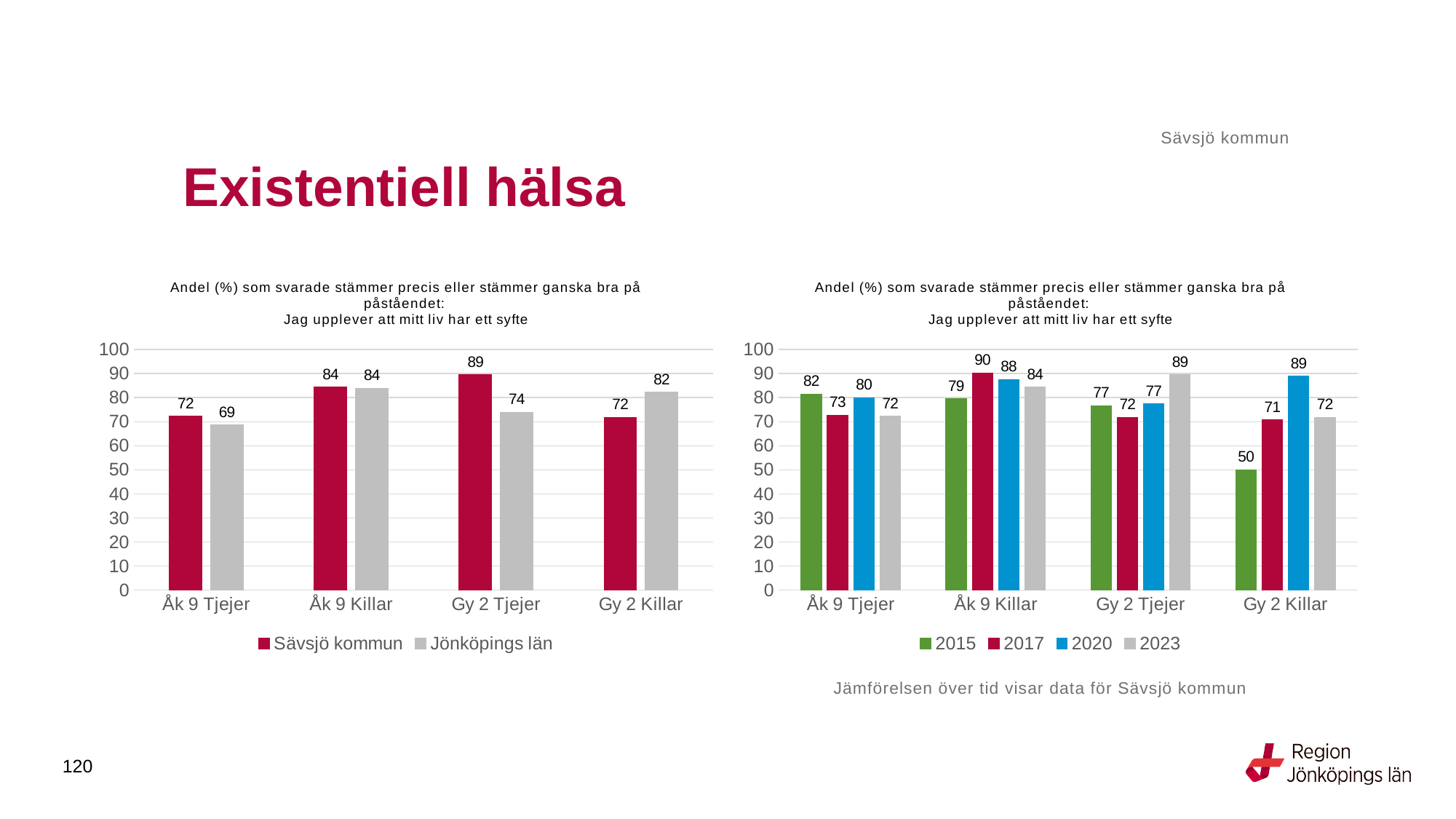
In the left chart, what is the value for Jönköpings län for Åk 9 Tjejer? 69 In the left chart, how many series does the legend list? 2 In the right chart, how many series does the legend list? 4 In the right chart, what is the difference between 2020 and 2017 for Gy 2 Killar? 18 What kind of chart is the left chart? Bar chart How many categories are shown on the x axis of the right chart? 4 In the left chart, what is the difference between Sävsjö kommun and Jönköpings län for Gy 2 Tjejer? 15 In the left chart, what is the value for Sävsjö kommun for Gy 2 Tjejer? 89 In the left chart, which is larger for Gy 2 Killar: Sävsjö kommun or Jönköpings län? Jönköpings län In the right chart, which year has the highest value for Åk 9 Killar? 2017 In the right chart, what is the value for 2015 for Gy 2 Killar? 50 In the right chart, which category has the lowest value for 2015? Gy 2 Killar